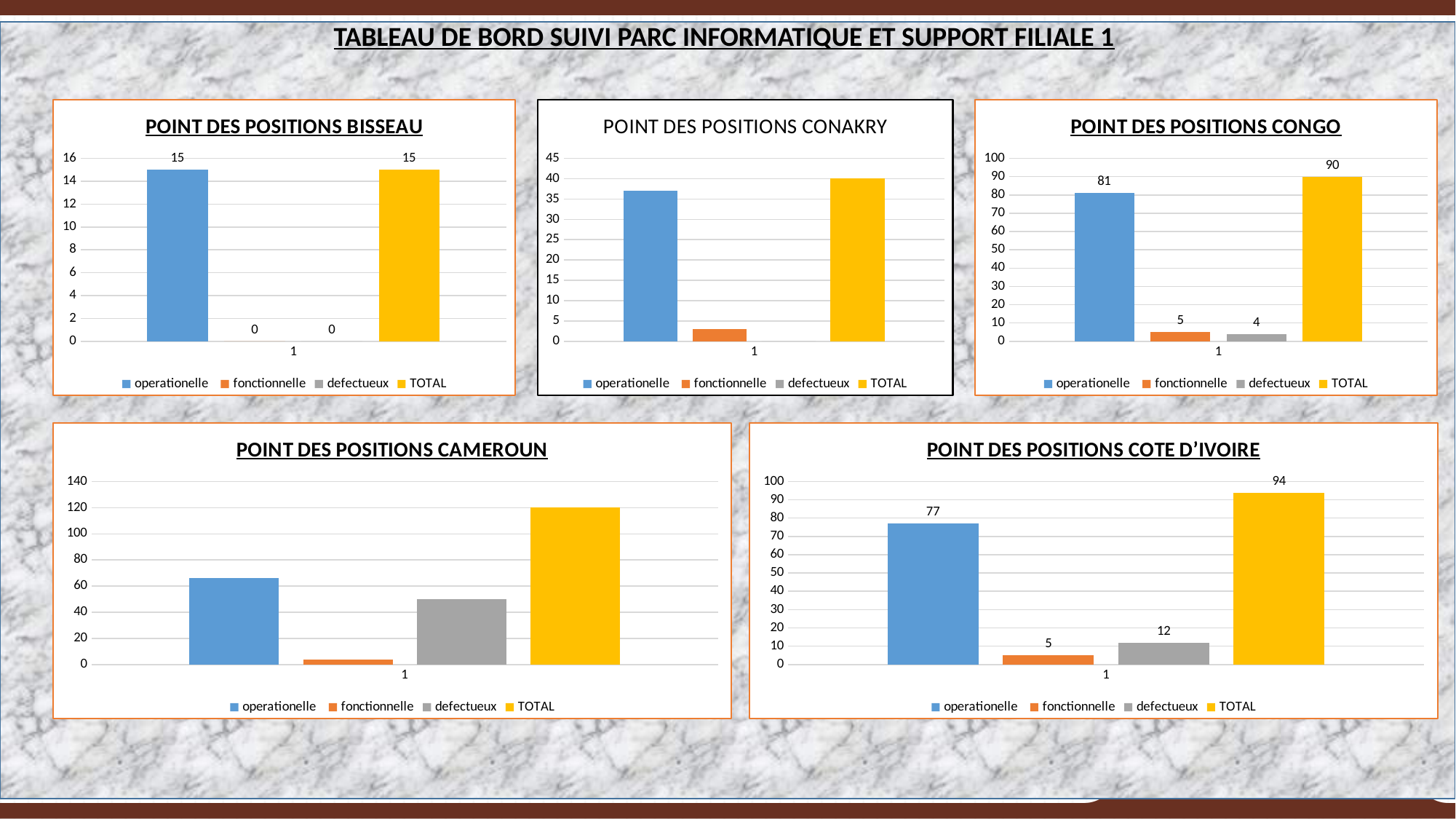
In the POINT DES POSITIONS CONGO chart, what is the value for operationelle? 81 In the POINT DES POSITIONS COTE D'IVOIRE chart, which series has the lowest value? fonctionnelle In the POINT DES POSITIONS BISSEAU chart, what is the value for fonctionnelle? 0 In the POINT DES POSITIONS CONGO chart, what is the value for defectueux? 4 In the POINT DES POSITIONS BISSEAU chart, what is the value for operationelle? 15 In the POINT DES POSITIONS COTE D'IVOIRE chart, what is the value for defectueux? 12 In the POINT DES POSITIONS CAMEROUN chart, which is larger, operationelle or defectueux? operationelle In the POINT DES POSITIONS COTE D'IVOIRE chart, what is the value for TOTAL? 94 In the POINT DES POSITIONS CONAKRY chart, is the value for operationelle greater or less than 30? greater In the POINT DES POSITIONS CAMEROUN chart, is the value for defectueux greater or less than 40? greater In the POINT DES POSITIONS CONGO chart, what is the difference between TOTAL and operationelle? 9 How many series does the legend of the POINT DES POSITIONS CONGO chart list? 4